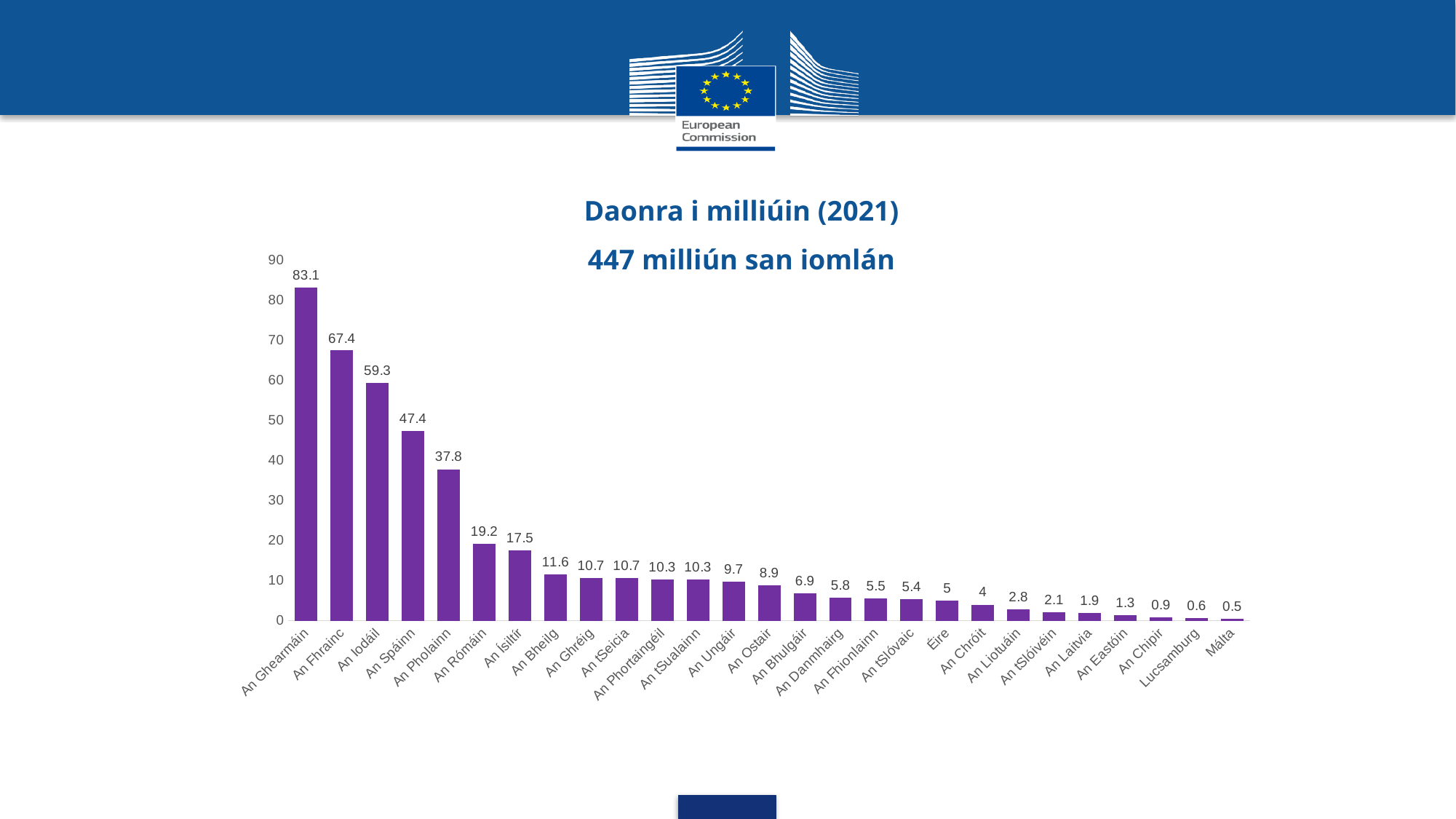
What is the difference between the values for An Fhrainc and An Iodáil? 8.1 Is the value for An Spáinn greater or less than 50? less How many categories are shown on the x axis? 27 What is the title of the chart? Daonra i milliúin (2021) What is the value shown for An Pholainn? 37.8 Which category has the lowest value? Málta What kind of chart is shown on the slide? bar chart Which is larger, the value for An Rómáin or the value for An Ísiltír? An Rómáin Which category has the highest value? An Ghearmáin What is the value shown for Lucsamburg? 0.6 What is the value shown for Éire? 5 What is the value shown for An Ghearmáin? 83.1